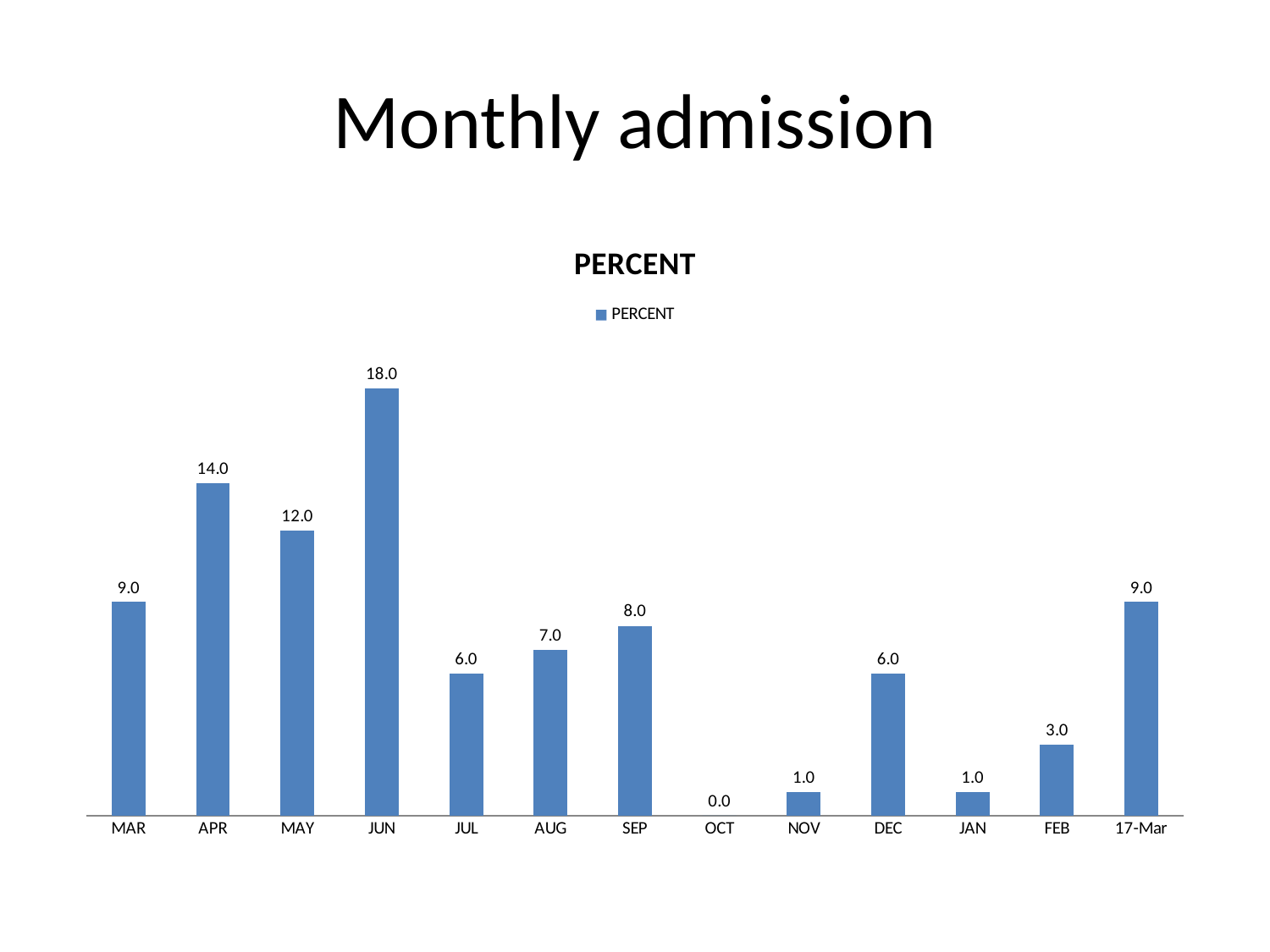
Which month has the lowest PERCENT value? OCT What is the title of the chart? PERCENT Which month has the highest PERCENT value? JUN Do the PERCENT values rise or fall from JUN to OCT? Fall How many series does the legend list? 1 How many categories are shown on the x axis? 13 What kind of chart is shown on the slide? Bar chart What is the PERCENT value for SEP? 8.0 What is the PERCENT value for JUN? 18.0 What is the PERCENT value for 17-Mar? 9.0 What is the difference between the PERCENT values for APR and MAY? 2.0 Which has a larger PERCENT value, AUG or DEC? AUG